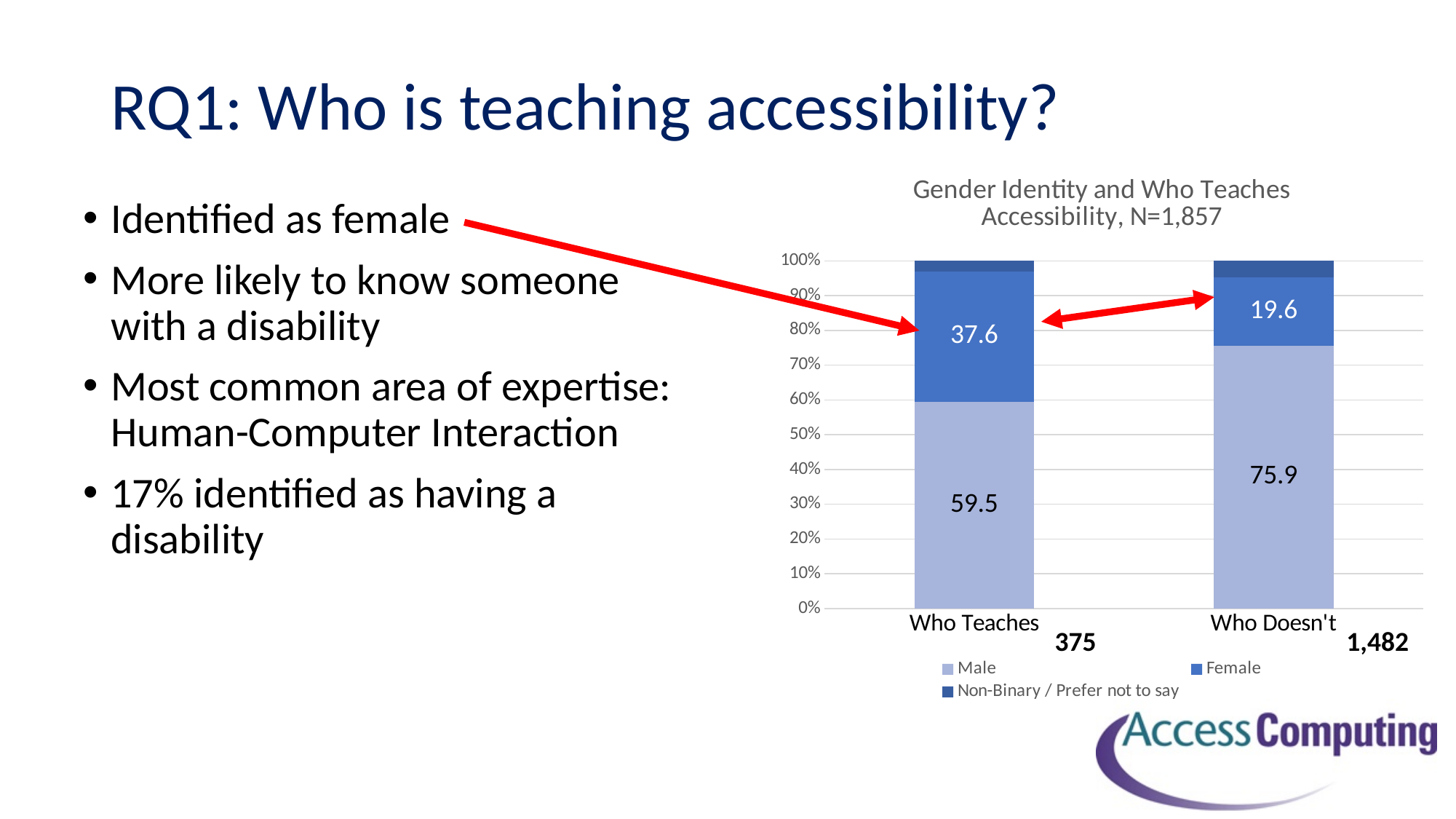
Which category has the higher Female value, Who Teaches or Who Doesn't? Who Teaches What is the difference between the Male values for Who Doesn't and Who Teaches? 16.4 What is the difference between the Female values for Who Teaches and Who Doesn't? 18 What is the Male value for the Who Doesn't bar? 75.9 How many categories are shown on the x axis? 2 What is the title of the chart? Gender Identity and Who Teaches Accessibility, N=1,857 What is the Male value for the Who Teaches bar? 59.5 What is the Female value for the Who Doesn't bar? 19.6 How many series does the legend list? 3 Which category has the higher Male value? Who Doesn't What kind of chart is shown on the slide? Stacked bar chart What is the Female value for the Who Teaches bar? 37.6